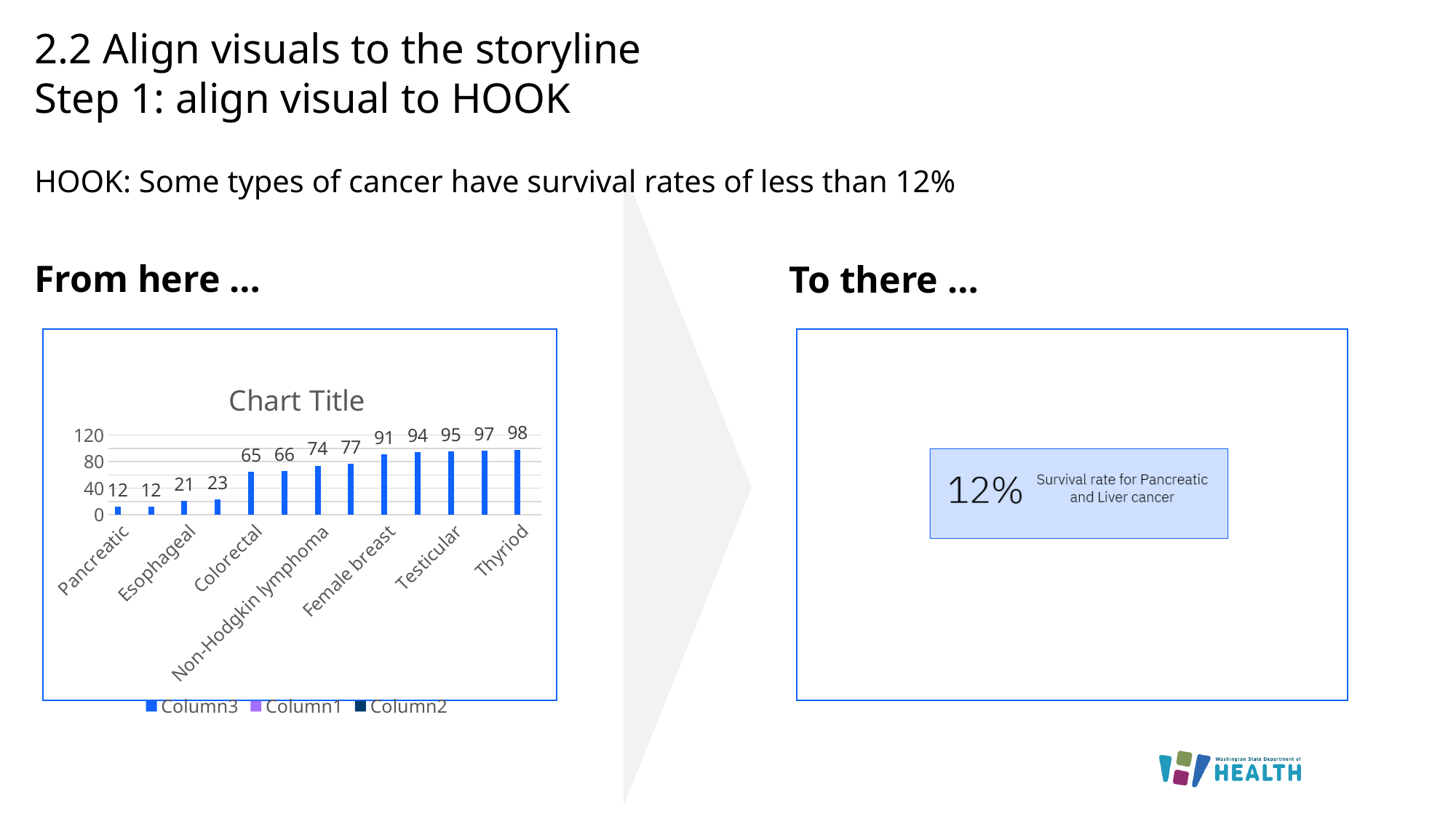
What is the value shown for Thyriod in the bar chart? 98 Do the values in the bar chart rise or fall from left to right along the x axis? Rise How many bars are plotted in the bar chart? 13 How many series does the legend of the bar chart list? 3 What is the difference between the values for Testicular and Colorectal? 30 What is the value shown for Pancreatic in the bar chart? 12 What kind of chart is shown on the left of the slide? Bar chart What is the value shown for Female breast in the bar chart? 91 Which labeled category has the highest value in the bar chart? Thyriod What is the value shown for Colorectal in the bar chart? 65 What is the difference between the values for Thyriod and Pancreatic? 86 Which has a larger value, Esophageal or Colorectal? Colorectal